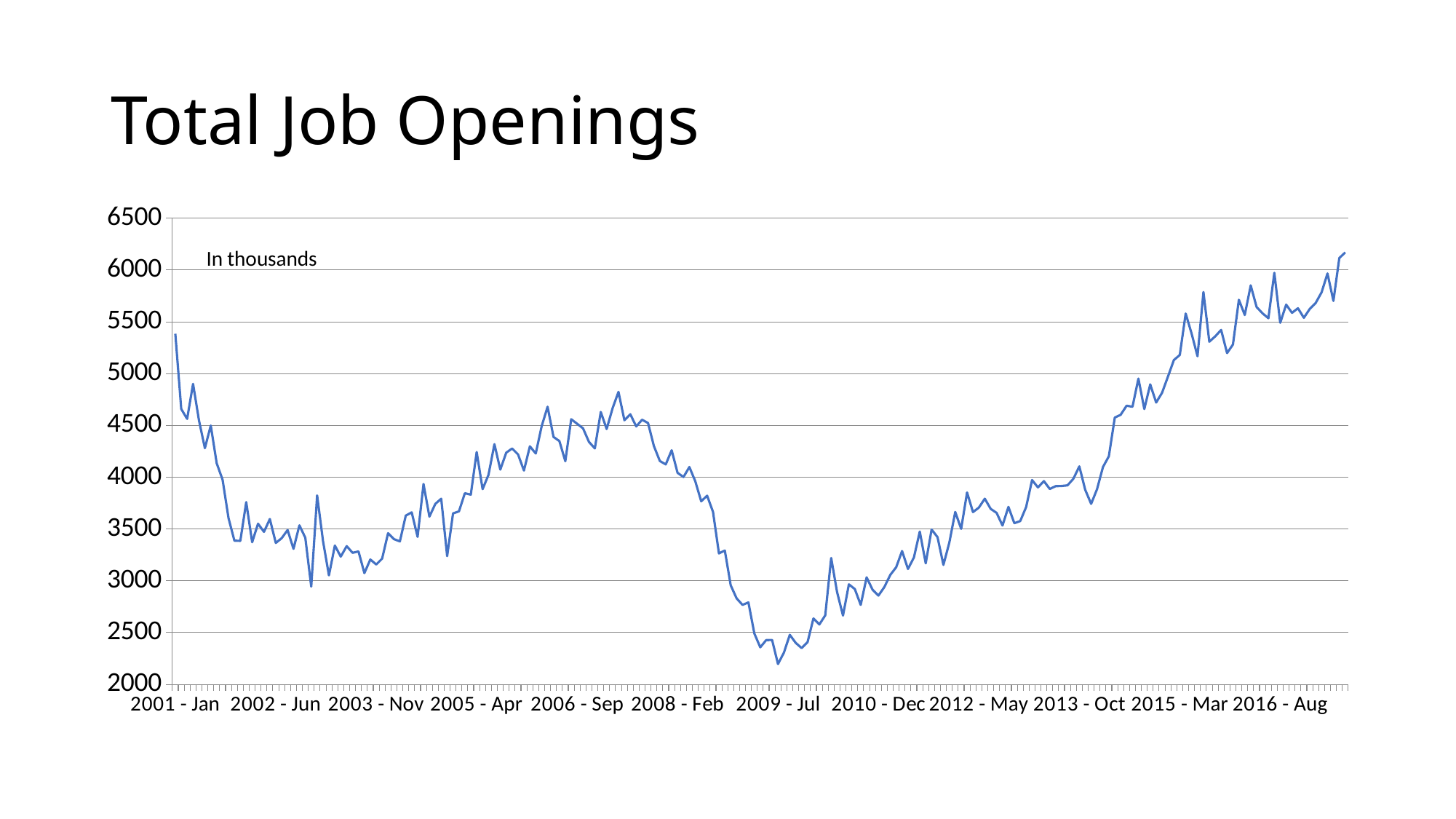
Does the line rise or fall between 2009 - Jul and 2016 - Aug? rise What kind of chart is shown on the slide? line chart Is the value at 2015 - Mar greater or less than 5000? greater Is the value at 2010 - Dec greater or less than 3500? less In what units are the values on the chart expressed, according to the note on the chart? In thousands What is the title of the chart? Total Job Openings How many date labels are shown along the x axis? 12 Is the value at 2002 - Jun greater or less than 4000? less Which is larger, the value at 2001 - Jan or the value at 2009 - Jul? 2001 - Jan Around which x-axis label does the line reach its lowest point? 2009 - Jul